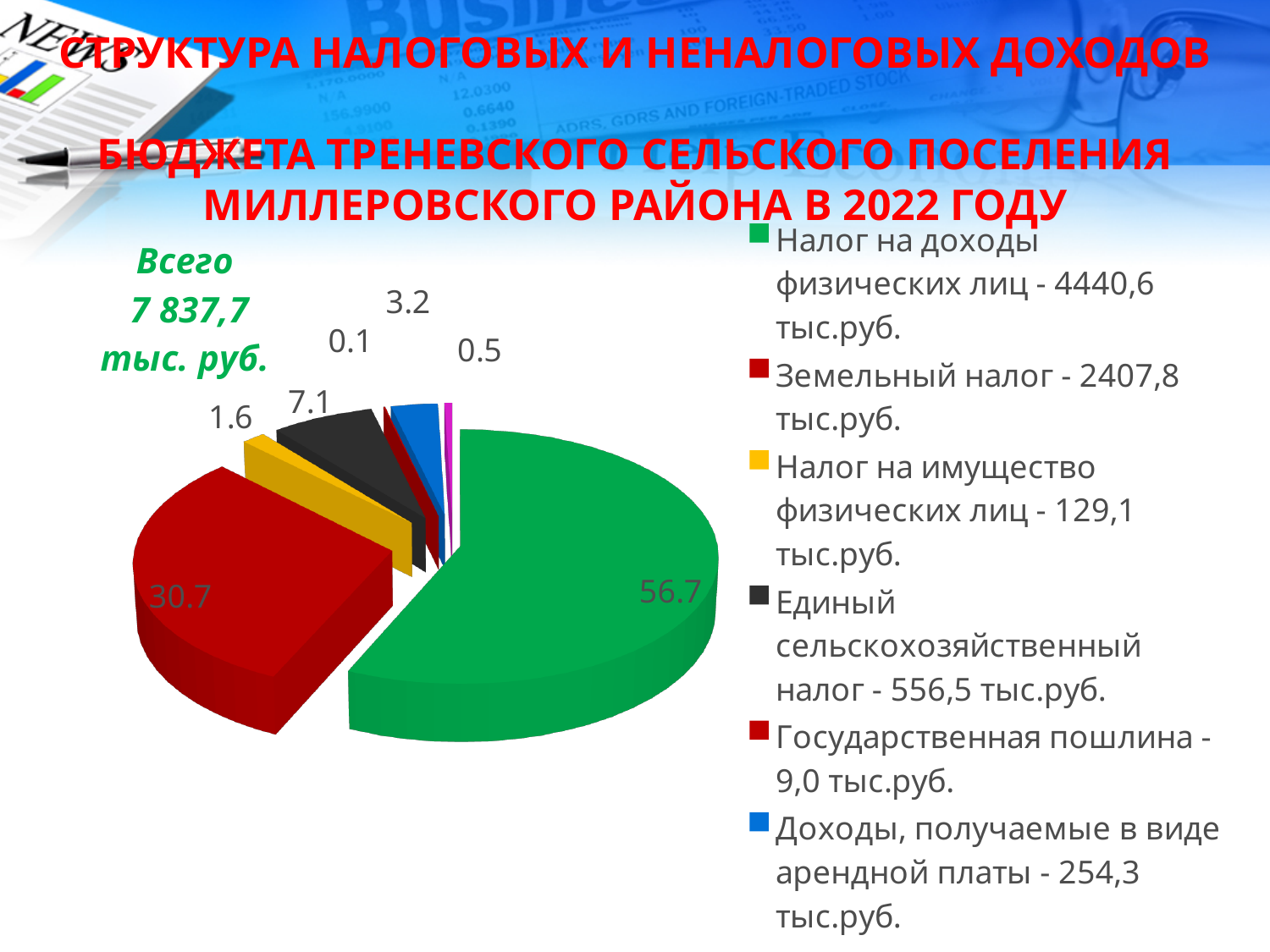
Which category has the largest slice of the pie? Налог на доходы физических лиц What type of chart is shown on the slide? pie chart What value is labelled on the slice for Налог на доходы физических лиц? 56.7 What is the smallest value labelled on the pie chart? 0.1 Which slice is larger: Единый сельскохозяйственный налог or Доходы, получаемые в виде арендной платы? Единый сельскохозяйственный налог What total amount (Всего) is shown next to the chart? 7 837,7 тыс. руб. How many slices does the pie chart have? 7 According to the legend, what is the amount for Земельный налог? 2407,8 тыс.руб. What is the difference between the labelled values for Налог на доходы физических лиц and Земельный налог? 26.0 What value is labelled on the slice for Единый сельскохозяйственный налог? 7.1 What colour is the slice for Налог на имущество физических лиц? yellow What value is labelled on the slice for Земельный налог? 30.7